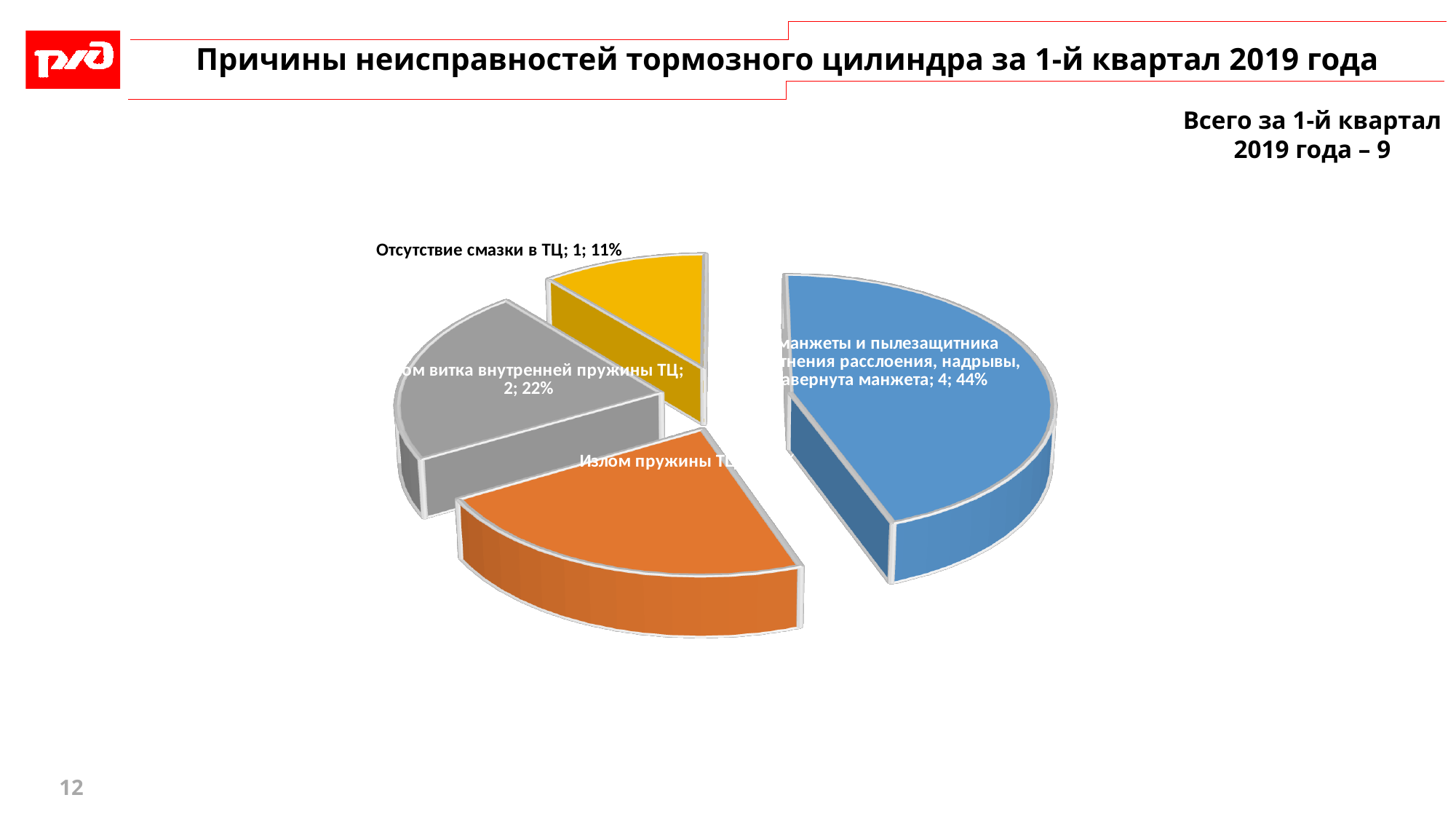
Which slice of the pie is the smallest? Отсутствие смазки в ТЦ How many slices does the pie chart have? 4 How many cases does the grey slice ('...витка внутренней пружины ТЦ') represent? 2 What share of the pie does the grey slice ('...витка внутренней пружины ТЦ') take? 22% What share of the pie does 'Отсутствие смазки в ТЦ' take? 11% What is the total number of cases for the 1st quarter of 2019 stated on the slide? 9 What kind of chart is shown on the slide? pie chart Which slice of the pie is the largest? the blue slice (4; 44%) Which is larger: the slice 'Отсутствие смазки в ТЦ' or the grey slice '...витка внутренней пружины ТЦ'? the grey slice '...витка внутренней пружины ТЦ' How many cases does the slice 'Отсутствие смазки в ТЦ' represent? 1 What is the title of the slide's chart? Причины неисправностей тормозного цилиндра за 1-й квартал 2019 года What is the difference in cases between the grey slice (2) and 'Отсутствие смазки в ТЦ' (1)? 1